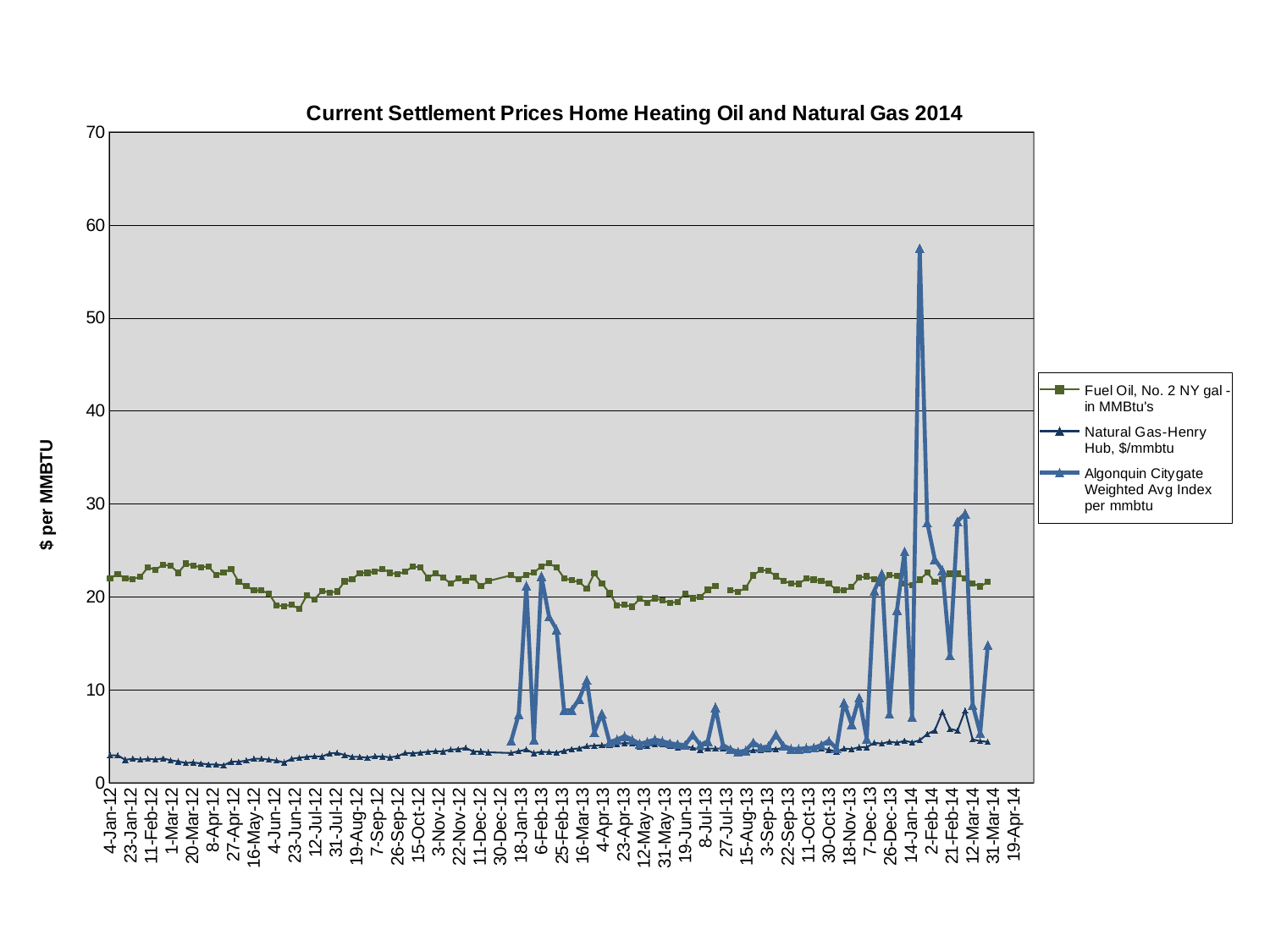
What is the title of the chart? Current Settlement Prices Home Heating Oil and Natural Gas 2014 Is the highest value of the Fuel Oil, No. 2 NY gal - in MMBtu's series greater or less than 30? less Is the peak value of the Algonquin Citygate Weighted Avg Index per mmbtu series greater or less than 50? greater On 4-Jan-12, which is higher: Fuel Oil, No. 2 NY gal - in MMBtu's or Natural Gas-Henry Hub, $/mmbtu? Fuel Oil, No. 2 NY gal - in MMBtu's What kind of chart is shown on the slide? line chart Which series reaches the highest value anywhere on the chart? Algonquin Citygate Weighted Avg Index per mmbtu Is the value of the Fuel Oil, No. 2 NY gal - in MMBtu's series on 4-Jan-12 greater or less than 20? greater Which series stays below 10 for the entire period shown? Natural Gas-Henry Hub, $/mmbtu What is the label on the vertical axis? $ per MMBTU How many series does the legend list? 3